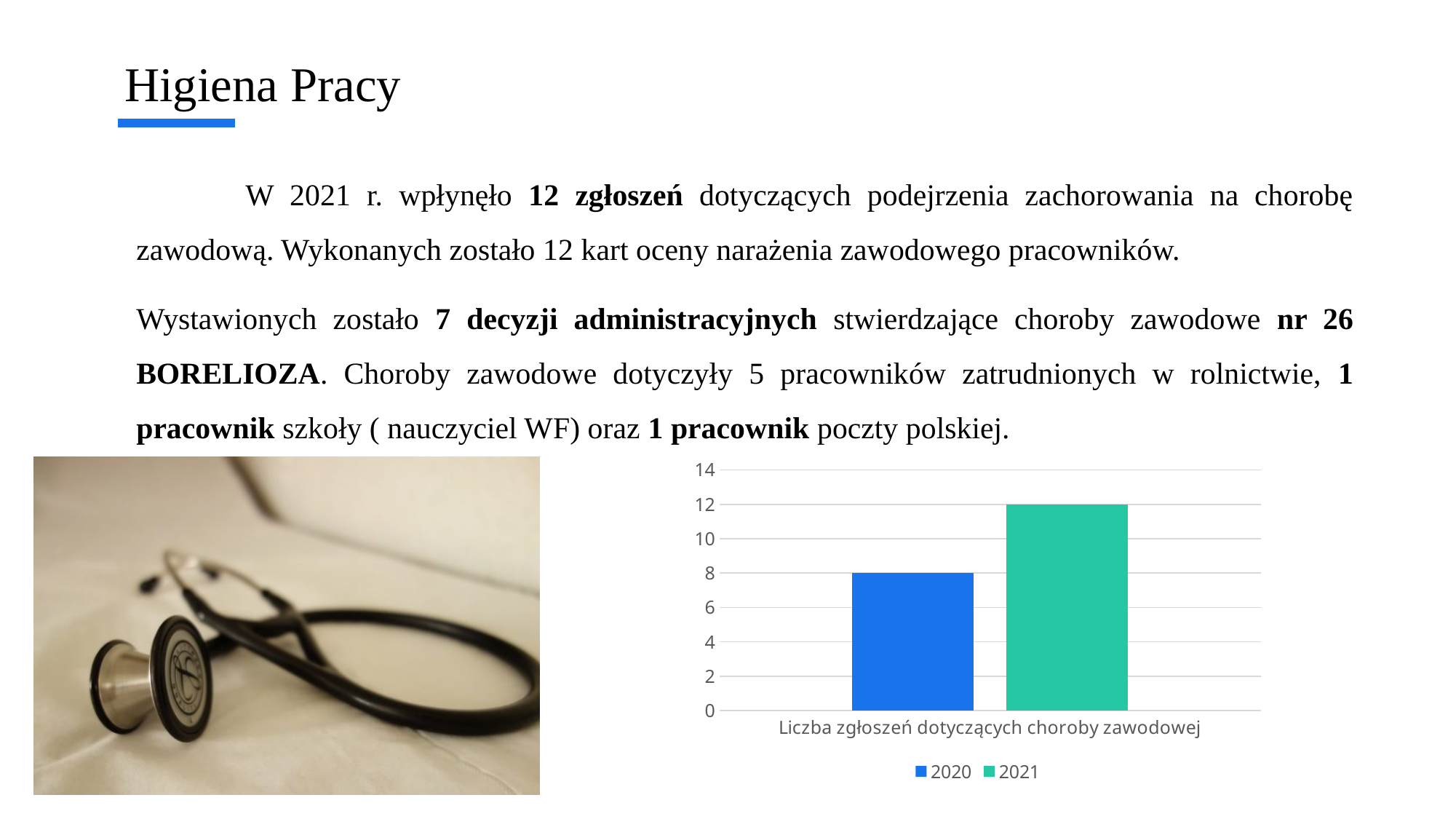
Is the value for 2021 greater or less than 10? greater What colour is the bar for the 2021 series? teal (green) What kind of chart is shown on the slide? bar chart Which series has the higher value in the chart, 2020 or 2021? 2021 Is the value for 2020 greater or less than 10? less How many series does the chart legend list? 2 What is the value of the 2020 bar for Liczba zgłoszeń dotyczących choroby zawodowej? 8 What is the difference between the 2021 and 2020 values in the chart? 4 What is the category label shown on the x axis of the chart? Liczba zgłoszeń dotyczących choroby zawodowej How many categories are shown on the x axis of the chart? 1 What is the value of the 2021 bar for Liczba zgłoszeń dotyczących choroby zawodowej? 12 Which series has the lowest bar in the chart? 2020